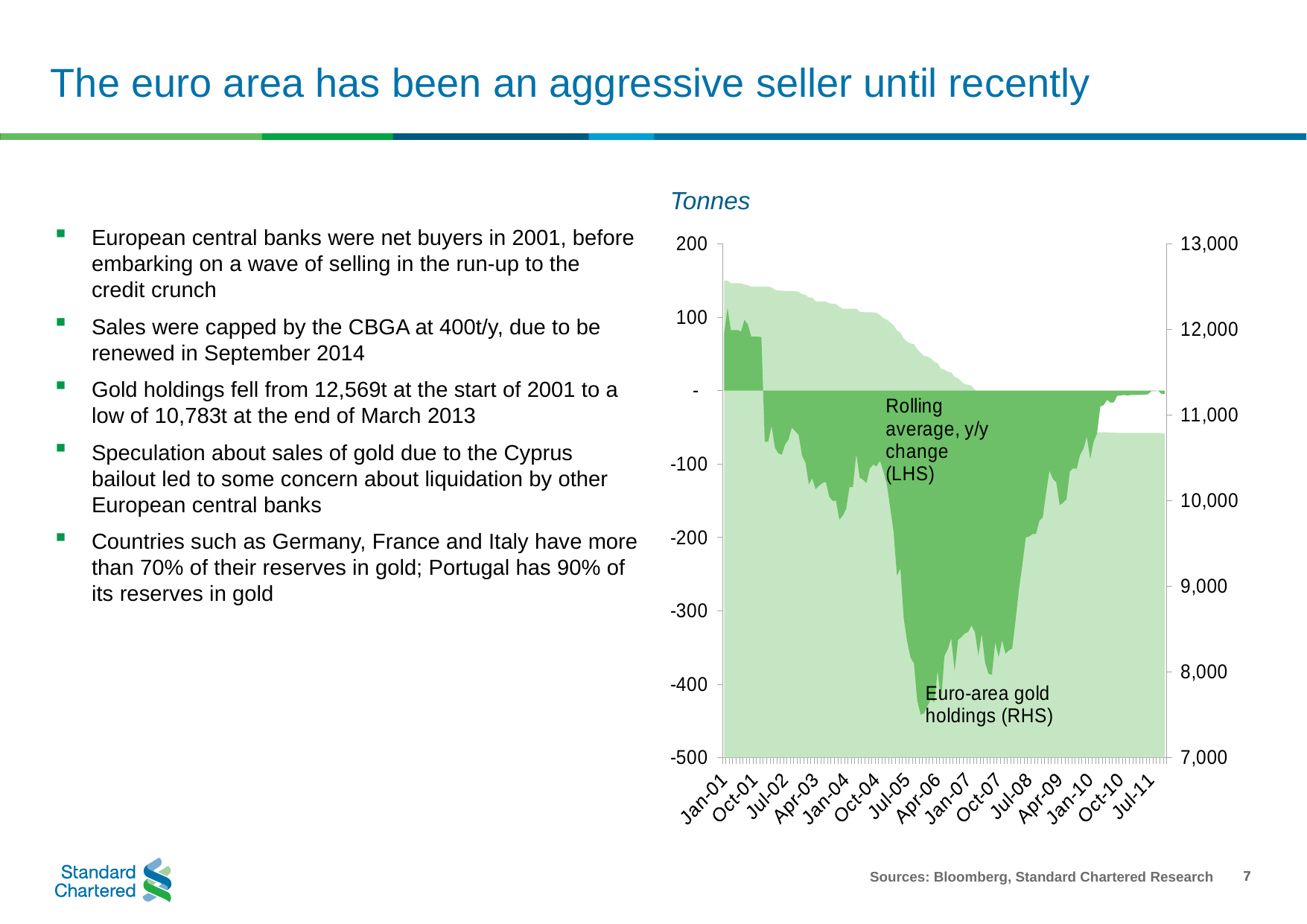
Is the rolling average y/y change at Jan-01 greater or less than 0? greater What is the highest value shown on the right-hand axis? 13,000 Is the value of Euro-area gold holdings at Jul-11 greater or less than 11,000? less Is the rolling average y/y change at Apr-06 greater or less than -300? less Which series is plotted against the right-hand axis (RHS)? Euro-area gold holdings How many series are plotted on the chart? 2 What kind of chart is shown on the slide? Area chart What unit is shown above the chart? Tonnes Does the Euro-area gold holdings series rise or fall from Jan-01 to Jul-11? Fall